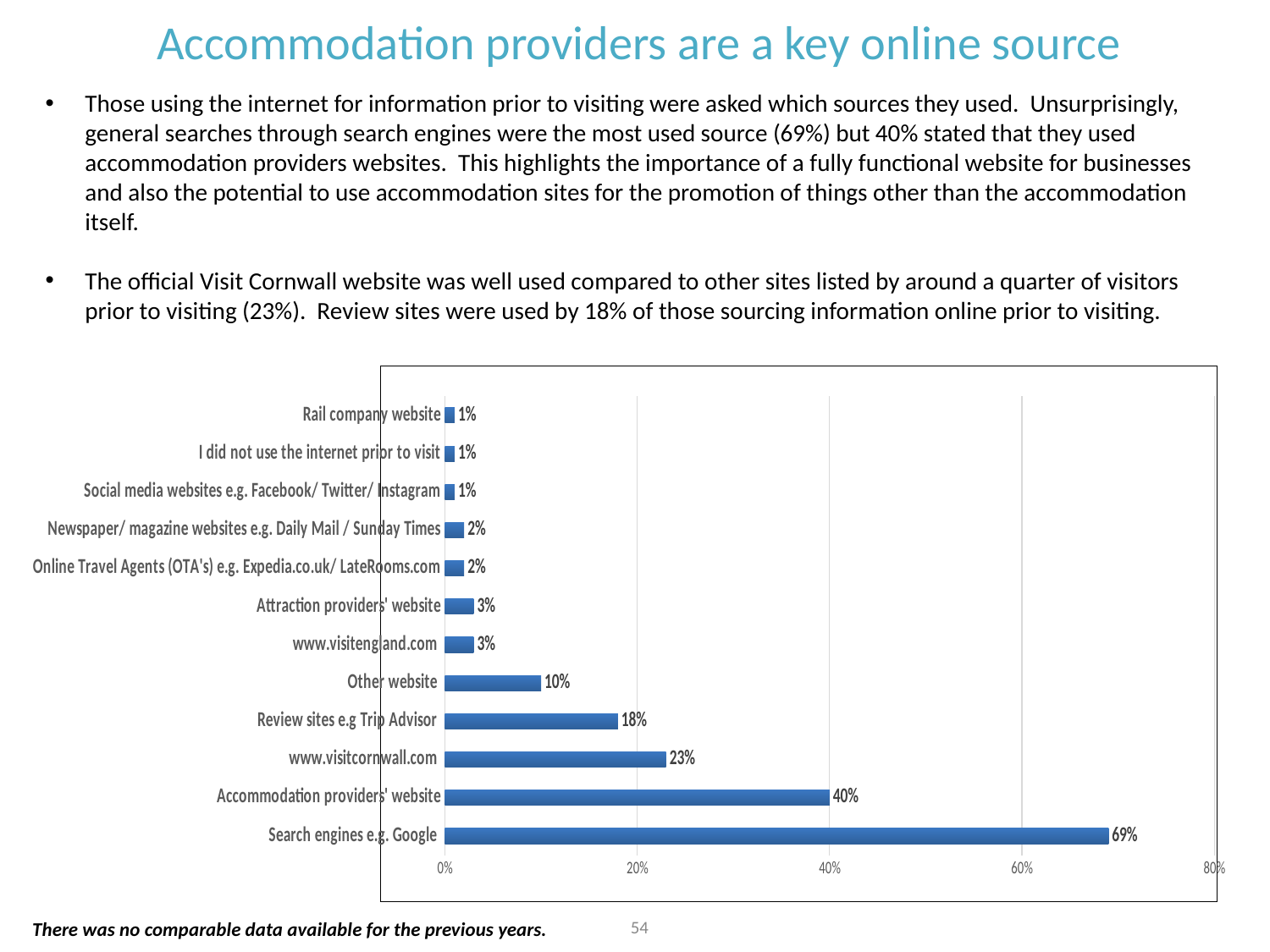
Is the value for Accommodation providers' website greater or less than 20%? greater What is the value for Accommodation providers' website? 40% Which category has the highest value in the chart? Search engines e.g. Google What kind of chart is shown on the slide? Bar chart What is the value for Review sites e.g Trip Advisor? 18% How many categories are shown in the chart? 12 What is the difference between the values for www.visitcornwall.com and Review sites e.g Trip Advisor? 5% What percentage of respondents used search engines e.g. Google? 69% Which is larger, the value for Other website or the value for www.visitengland.com? Other website What is the difference between the values for Search engines e.g. Google and Accommodation providers' website? 29% What percentage used www.visitcornwall.com? 23% What is the highest value shown on the horizontal axis of the chart? 80%